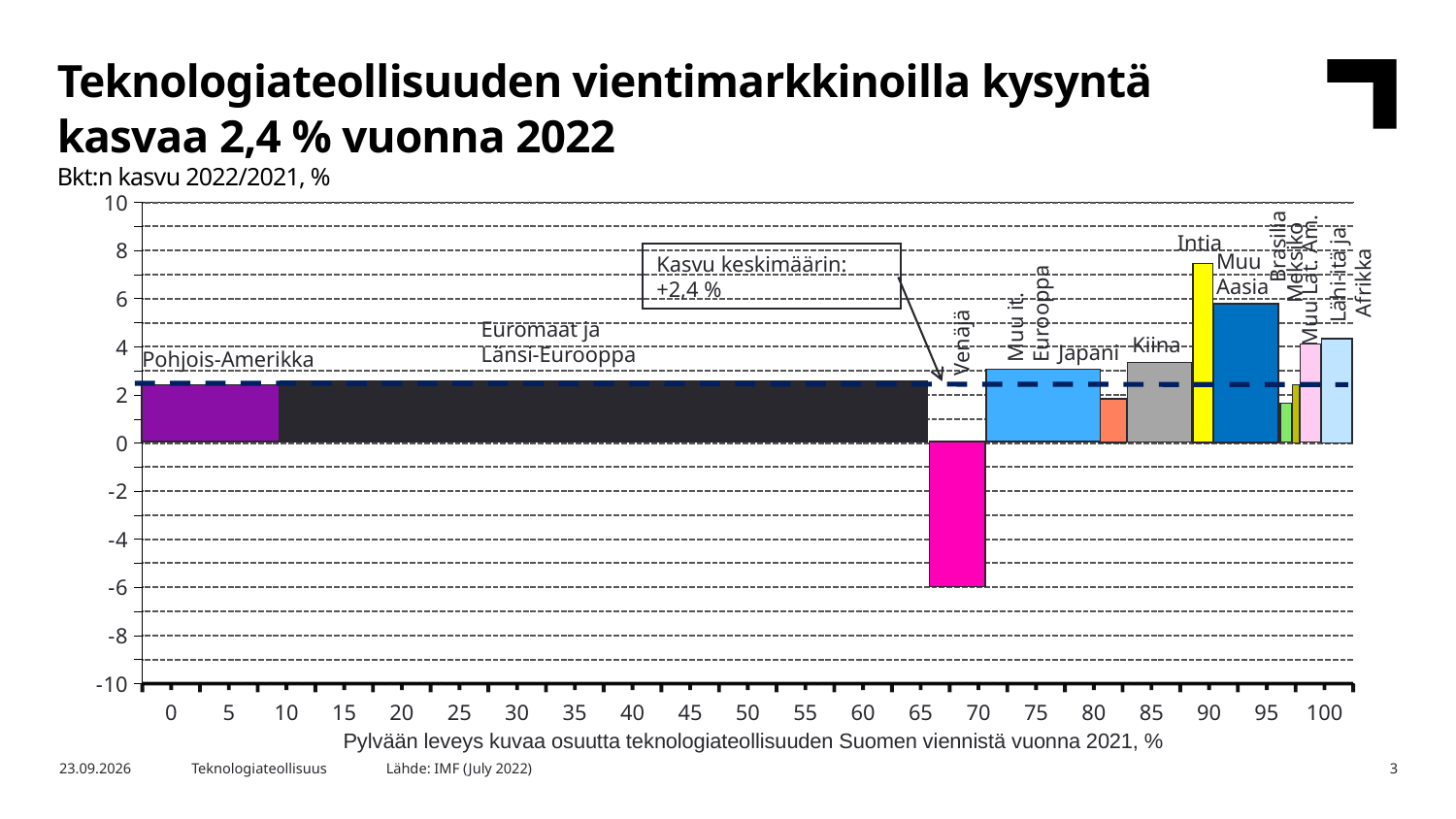
Which category has the highest GDP growth value in the chart? Intia Which has the larger value, Lähi-itä ja Afrikka or Japani? Lähi-itä ja Afrikka What average growth value is indicated by the dashed line annotation on the chart? +2,4 % Is the value for Muu Aasia greater or less than 4? greater Which has the larger value, Intia or Kiina? Intia Which category has the lowest GDP growth value in the chart? Venäjä How many categories (bars) are shown in the chart? 12 Is the value for Intia greater or less than 6? greater What kind of chart is shown on the slide? bar chart Is the value for Venäjä greater or less than 0? less